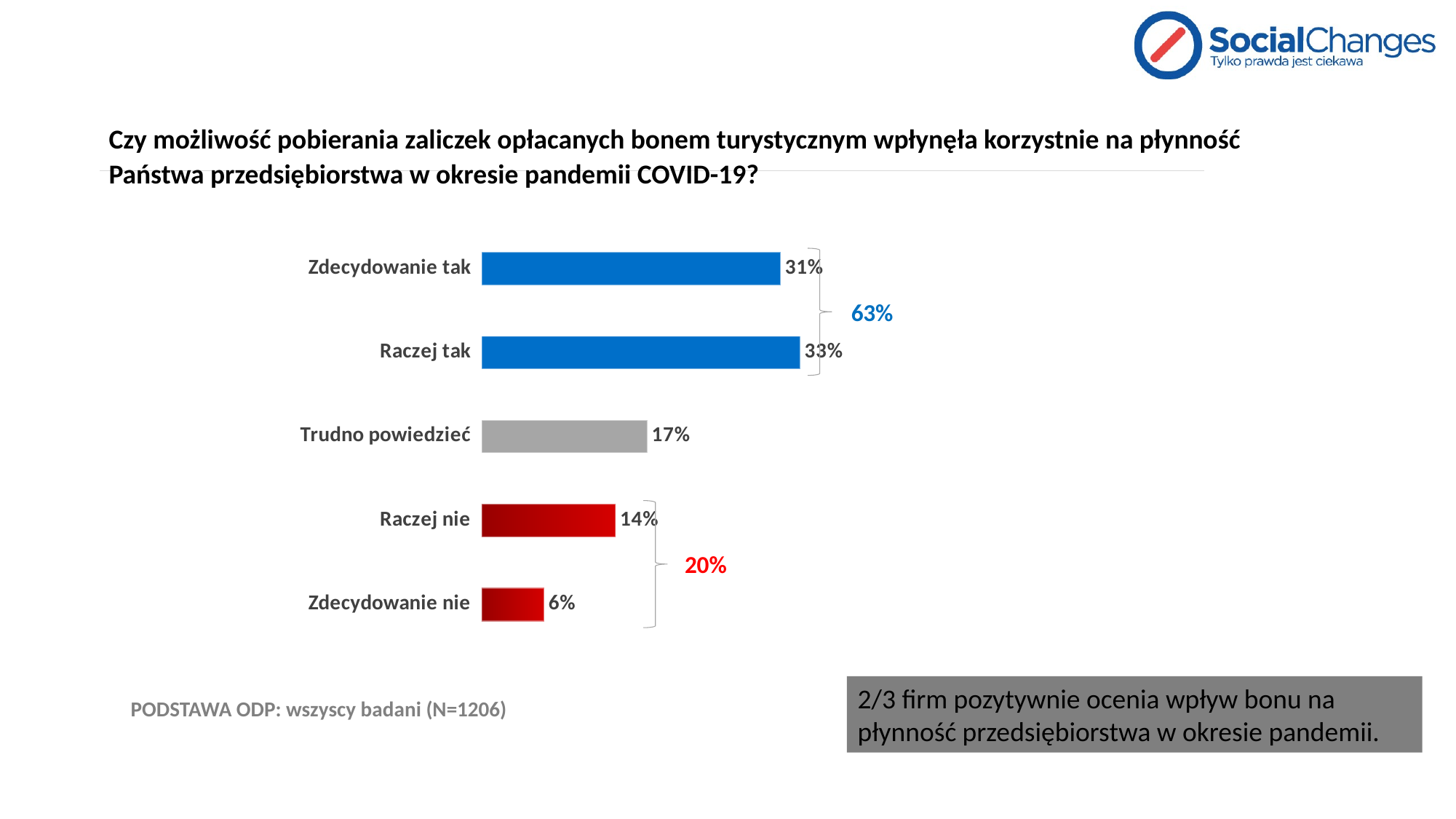
What is the difference between the values for "Raczej tak" and "Zdecydowanie tak"? 2% What kind of chart is shown on the slide? Bar chart Which category has the lowest value? Zdecydowanie nie What combined percentage is shown for the two "tak" answers (Zdecydowanie tak and Raczej tak)? 63% What is the difference between the values for "Trudno powiedzieć" and "Raczej nie"? 3% Which is larger, the value for "Raczej nie" or the value for "Zdecydowanie nie"? Raczej nie What is the value for "Raczej tak"? 33% What is the value for "Trudno powiedzieć"? 17% What colour are the bars for "Zdecydowanie tak" and "Raczej tak"? Blue How many categories are shown in the chart? 5 Which category has the highest value? Raczej tak What is the value for "Zdecydowanie nie"? 6%